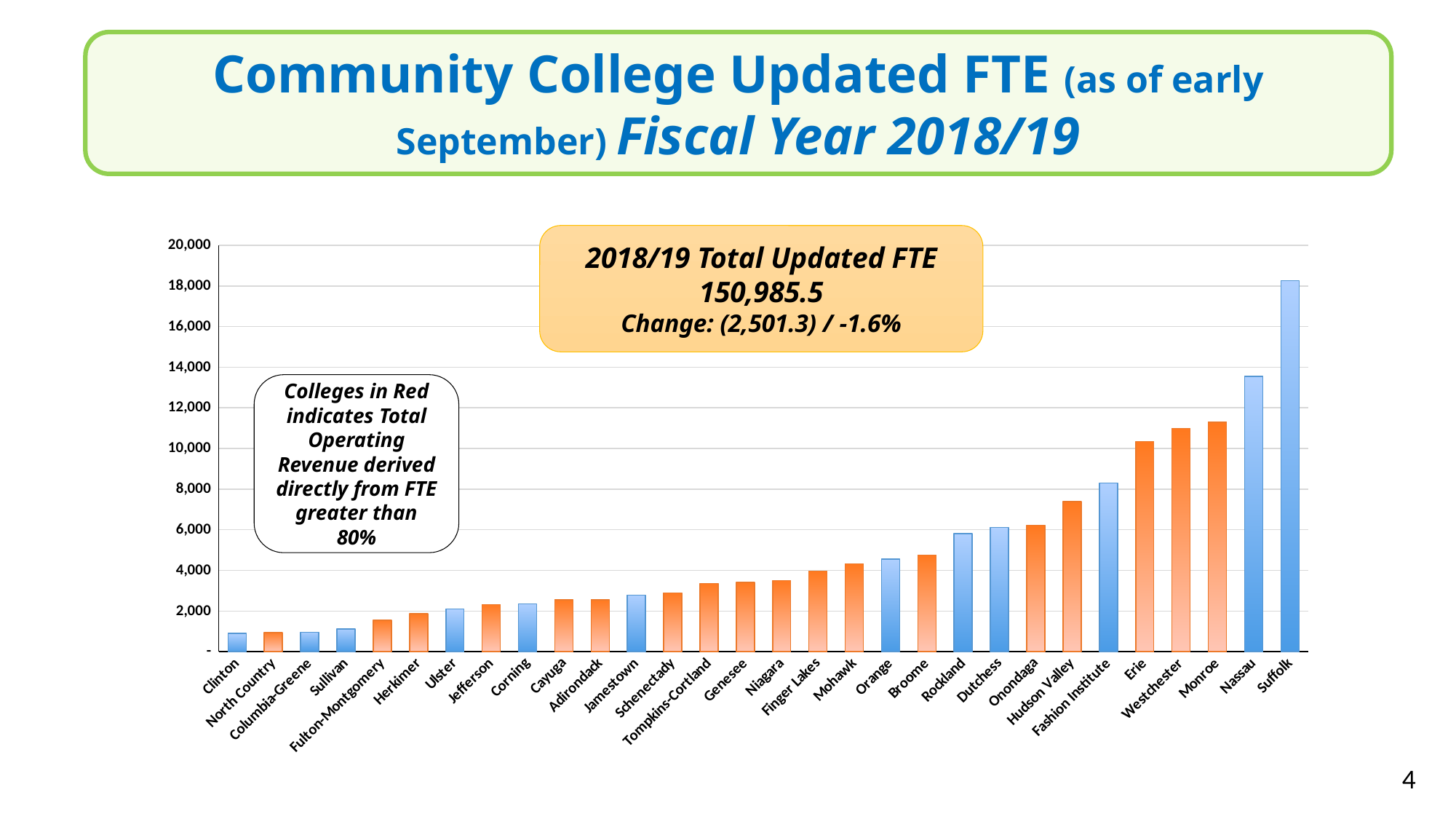
Is the value for Hudson Valley greater or less than 8,000? less How many colleges are shown along the x axis of the chart? 30 Which has a larger updated FTE, Nassau or Monroe? Nassau Which college has the highest updated FTE in the chart? Suffolk Do the bar values rise or fall moving from left to right along the x axis? rise Is the value for Orange greater or less than 4,000? greater What is the 2018/19 Total Updated FTE stated in the callout box on the chart? 150,985.5 What kind of chart is shown on the slide? bar chart Is the value for Suffolk greater or less than 16,000? greater According to the note on the chart, what do colleges shown in red indicate? Total Operating Revenue derived directly from FTE greater than 80%